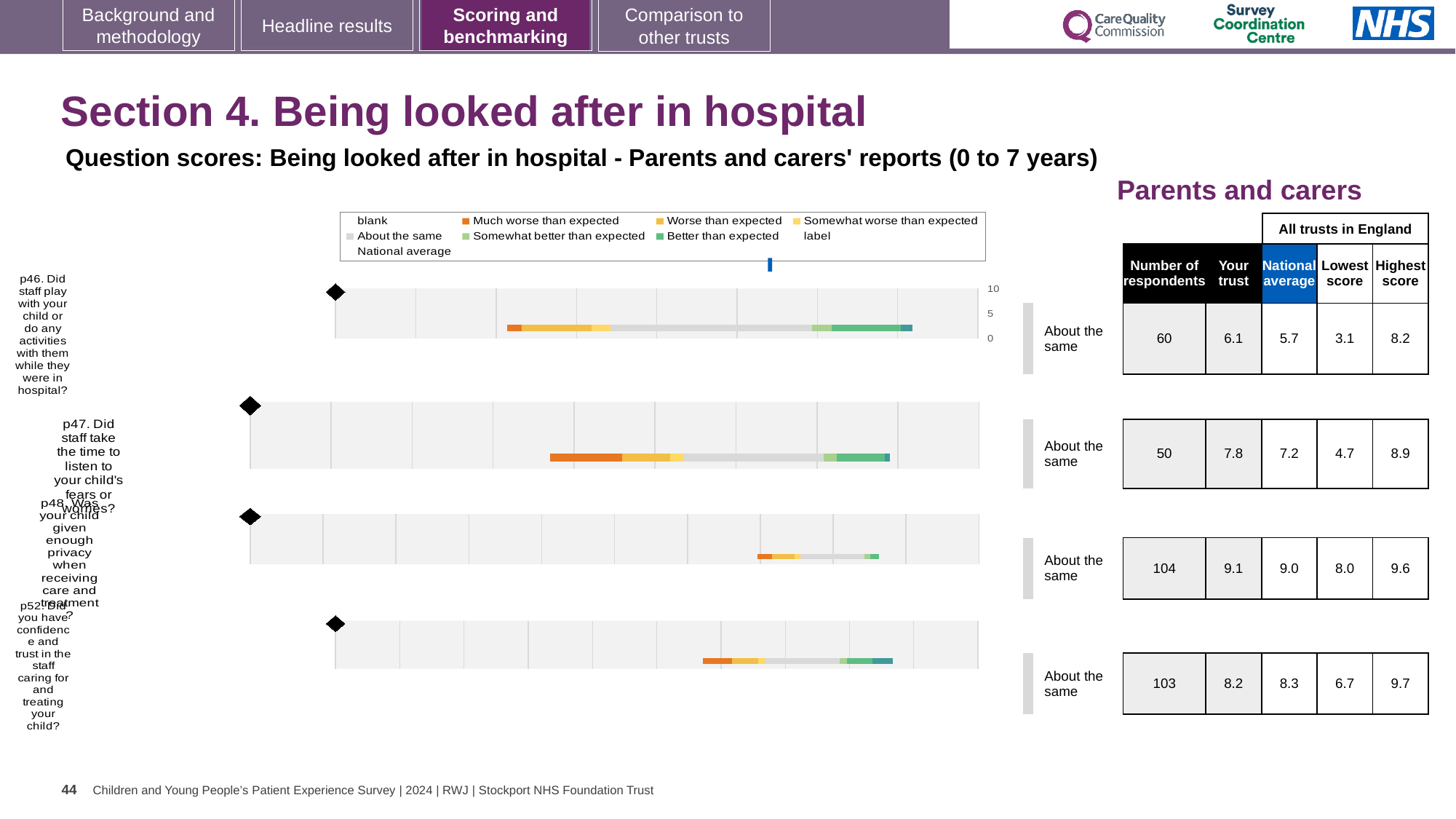
What is the national average score for p47 (Did staff take the time to listen to your child's fears or worries?)? 7.2 How many questions (categories) are plotted on the slide? 4 What kind of chart is used to show the question scores on this slide? bar chart For p52, which is larger: the 'Your trust' score or the national average? National average Which question has the lowest 'Your trust' score? p46 For p47, what is the difference between the 'Your trust' score and the national average? 0.6 Which question has the highest 'Your trust' score? p48 How many respondents answered p48 (Was your child given enough privacy when receiving care and treatment?)? 104 What is the highest score among all trusts in England for p52? 9.7 What is the 'Your trust' score for p46 (Did staff play with your child or do any activities with them while they were in hospital?)? 6.1 What is the lowest score among all trusts in England for p46? 3.1 What benchmark category is shown for p46? About the same